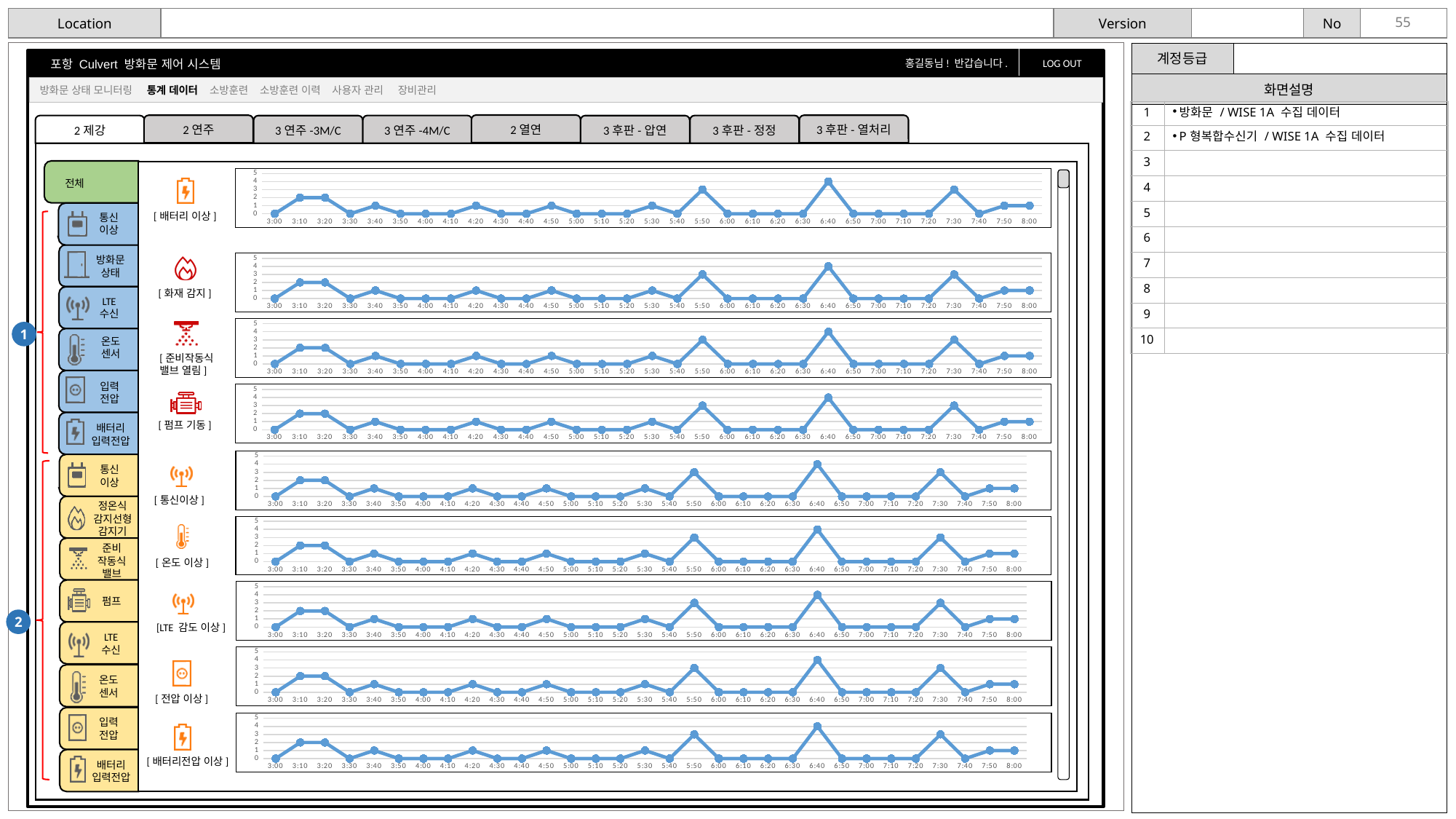
In the [전압 이상] chart, which is larger, the value at 3:10 or the value at 3:30? 3:10 In the [배터리전압 이상] chart, does the value rise or fall from 6:40 to 6:50? fall In the [펌프 기동] chart, is the value at 6:40 greater or less than 3? greater In the [화재 감지] chart, at which time is the value highest? 6:40 In the [통신이상] chart, is the value at 3:00 greater or less than 1? less What is the first time label on the x axis of the [준비작동식 밸브 열림] chart? 3:00 In the [온도 이상] chart, is the value at 5:50 greater or less than 2? greater How many line charts are shown on the slide? 9 In the [배터리 이상] chart, at which time is the value highest? 6:40 In the [LTE 감도 이상] chart, which is larger, the value at 6:40 or the value at 5:50? 6:40 What kind of chart is the [배터리 이상] chart? line chart What is the highest tick value on the y axis of the [화재 감지] chart? 5